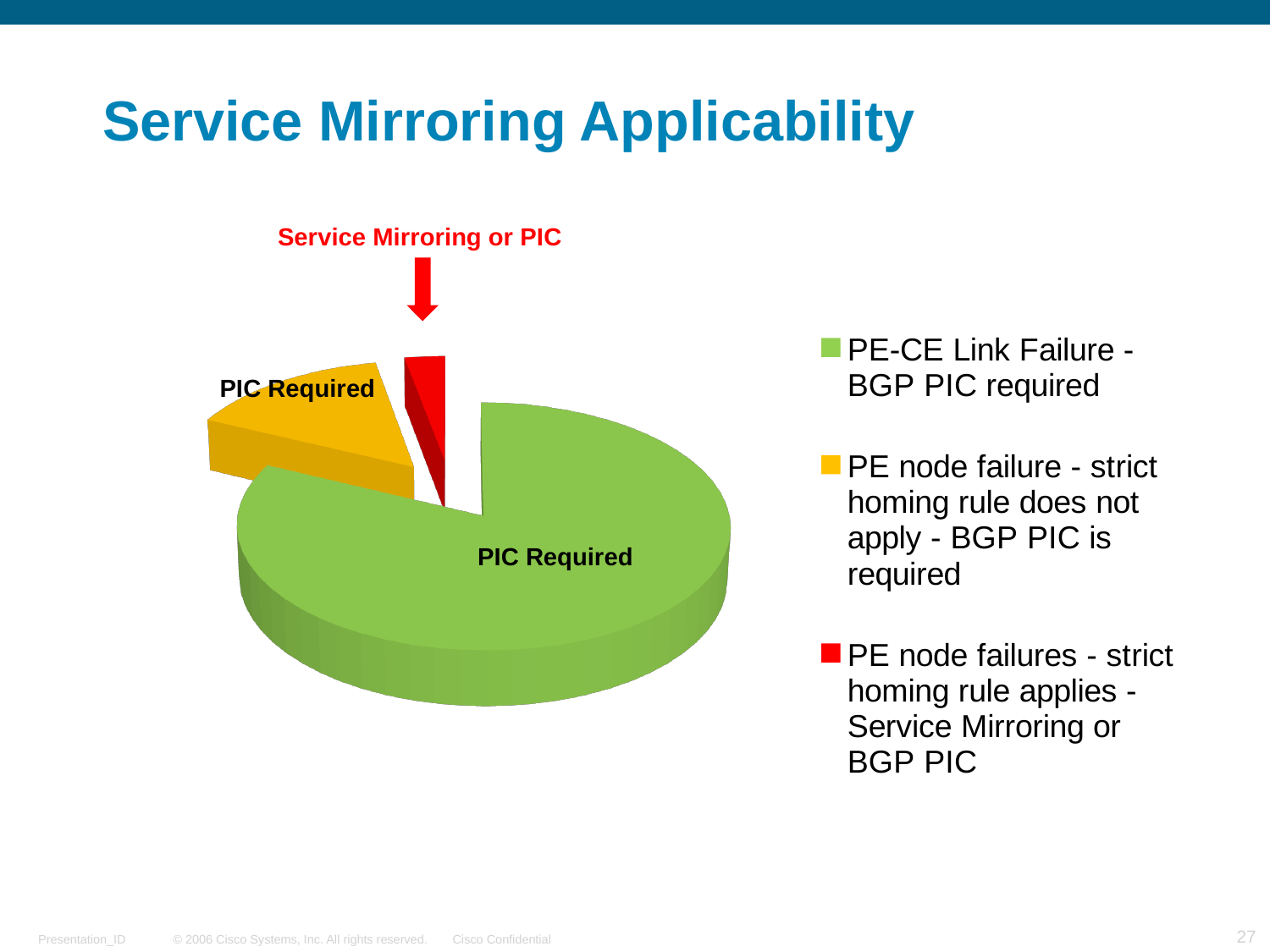
How many entries does the legend of the pie chart list? 3 Which slice is larger: the one for 'PE node failure - strict homing rule does not apply - BGP PIC is required' or the one for 'PE node failures - strict homing rule applies - Service Mirroring or BGP PIC'? PE node failure - strict homing rule does not apply - BGP PIC is required Which legend category has the largest slice of the pie chart? PE-CE Link Failure - BGP PIC required What colour is the slice for 'PE-CE Link Failure - BGP PIC required' in the pie chart? Green What label is attached by the red arrow to the red slice of the pie chart? Service Mirroring or PIC How many slices does the pie chart have? 3 Which legend category has the smallest slice of the pie chart? PE node failures - strict homing rule applies - Service Mirroring or BGP PIC What kind of chart is shown on the slide? Pie chart Which slice is larger: the one for 'PE-CE Link Failure - BGP PIC required' or the one for 'PE node failure - strict homing rule does not apply - BGP PIC is required'? PE-CE Link Failure - BGP PIC required